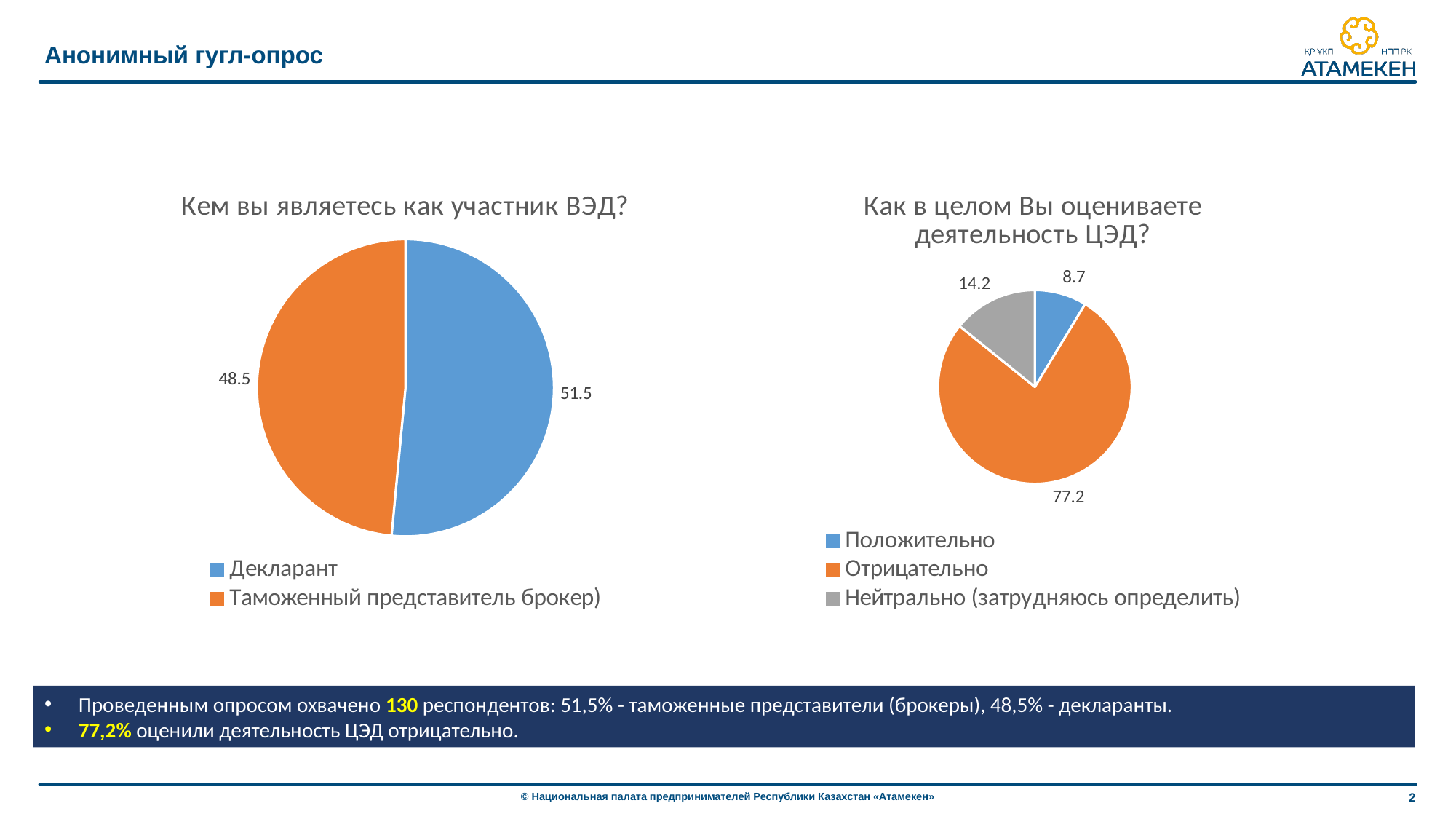
In the chart titled "Как в целом Вы оцениваете деятельность ЦЭД?", what value is shown for Нейтрально (затрудняюсь определить)? 14.2 In the chart titled "Как в целом Вы оцениваете деятельность ЦЭД?", what is the difference between the values for Нейтрально (затрудняюсь определить) and Положительно? 5.5 In the chart titled "Кем вы являетесь как участник ВЭД?", what value is shown for Таможенный представитель брокер)? 48.5 In the chart titled "Как в целом Вы оцениваете деятельность ЦЭД?", what value is shown for Положительно? 8.7 In the chart titled "Как в целом Вы оцениваете деятельность ЦЭД?", which category has the smallest slice? Положительно In the chart titled "Как в целом Вы оцениваете деятельность ЦЭД?", what value is shown for Отрицательно? 77.2 In the chart titled "Кем вы являетесь как участник ВЭД?", what is the difference between the values for Декларант and Таможенный представитель брокер)? 3.0 In the chart titled "Как в целом Вы оцениваете деятельность ЦЭД?", what colour is the slice for Нейтрально (затрудняюсь определить)? Grey In the chart titled "Кем вы являетесь как участник ВЭД?", what value is shown for Декларант? 51.5 What kind of chart is the one titled "Кем вы являетесь как участник ВЭД?"? Pie chart In the chart titled "Кем вы являетесь как участник ВЭД?", how many series does the legend list? 2 In the chart titled "Как в целом Вы оцениваете деятельность ЦЭД?", which category has the largest slice? Отрицательно